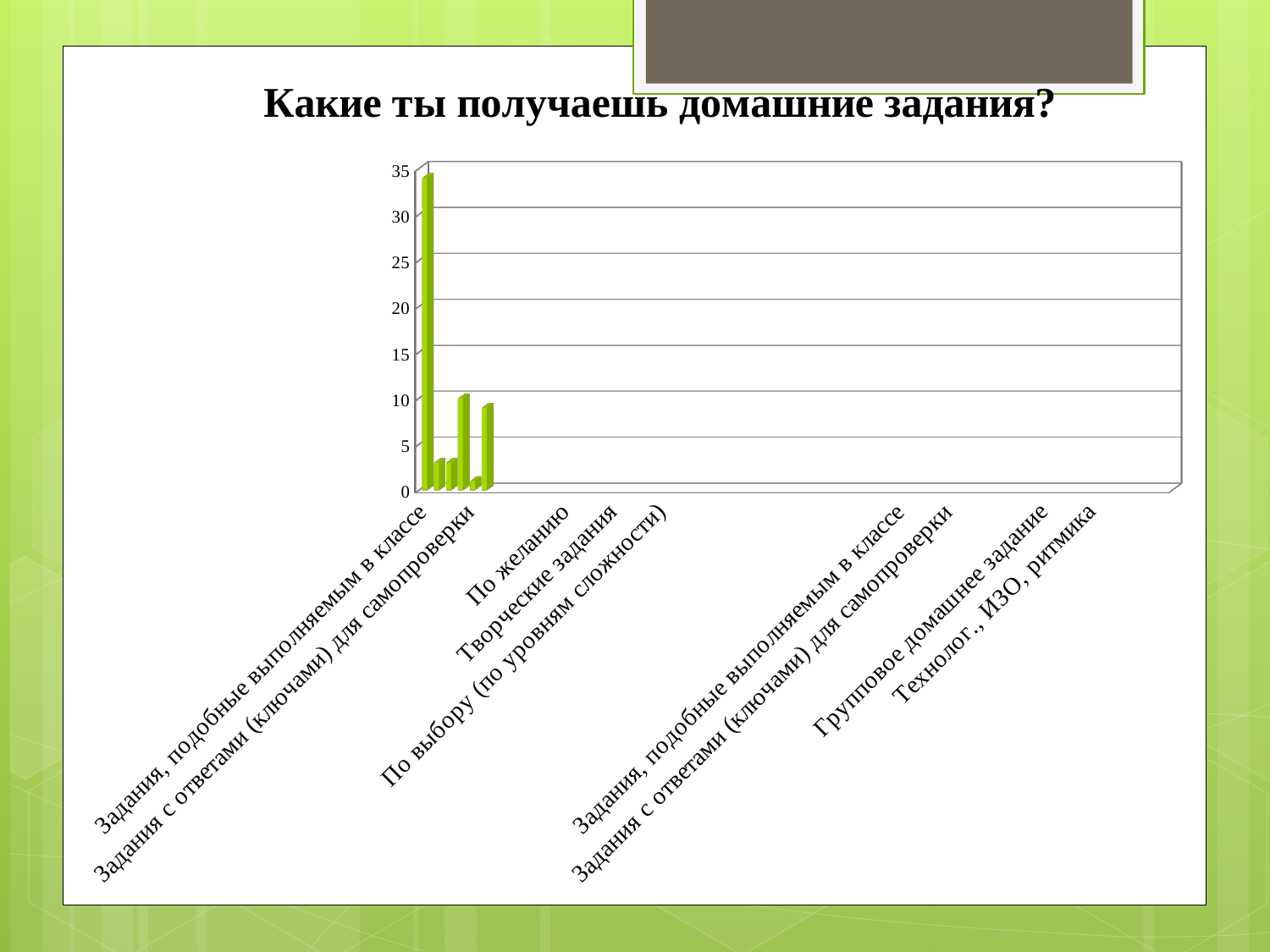
Which category has the tallest bar in the chart? Задания, подобные выполняемым в классе What kind of chart is shown on the slide? bar chart What is the highest value shown on the vertical axis of the chart? 35 Is the value of the tallest bar in the chart greater or less than 20? greater Is the value of the fourth bar from the left greater or less than 15? less Does the chart have a legend? No Which is larger, the first bar from the left or the fourth bar from the left? the first bar Is the value of the tallest bar in the chart greater or less than 30? greater What is the title of the chart? Какие ты получаешь домашние задания?